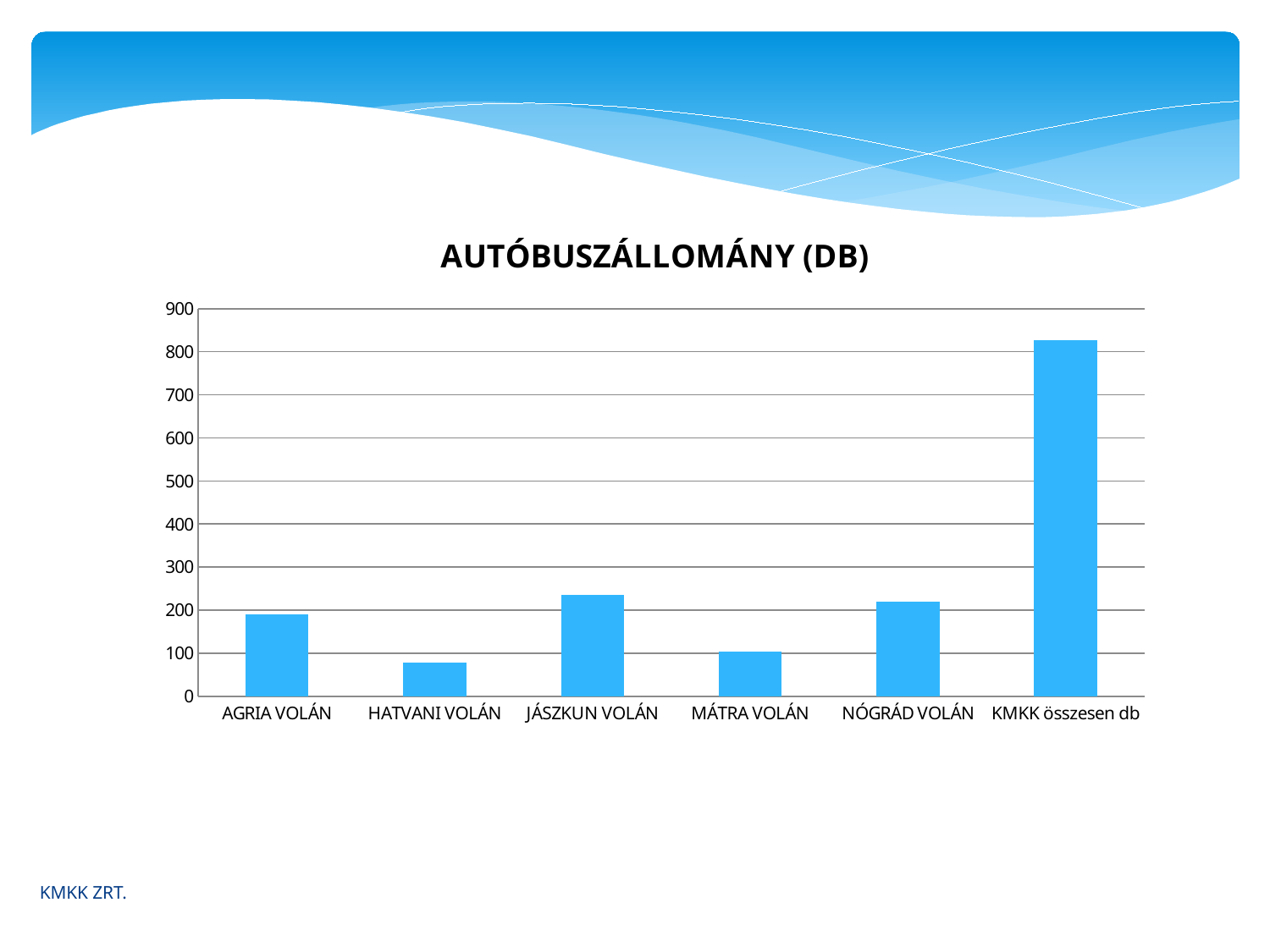
Which is larger, the value for AGRIA VOLÁN or the value for HATVANI VOLÁN? AGRIA VOLÁN Is the value for NÓGRÁD VOLÁN greater or less than 300? less Which category has the lowest bar in the chart? HATVANI VOLÁN Is the value for AGRIA VOLÁN greater or less than 100? greater What type of chart is shown on the slide? bar chart Is the value for JÁSZKUN VOLÁN greater or less than 200? greater What is the title of the chart? AUTÓBUSZÁLLOMÁNY (DB) Which is larger, the value for MÁTRA VOLÁN or the value for NÓGRÁD VOLÁN? NÓGRÁD VOLÁN Which category has the highest bar in the chart? KMKK összesen db How many categories are shown on the x axis of the chart? 6